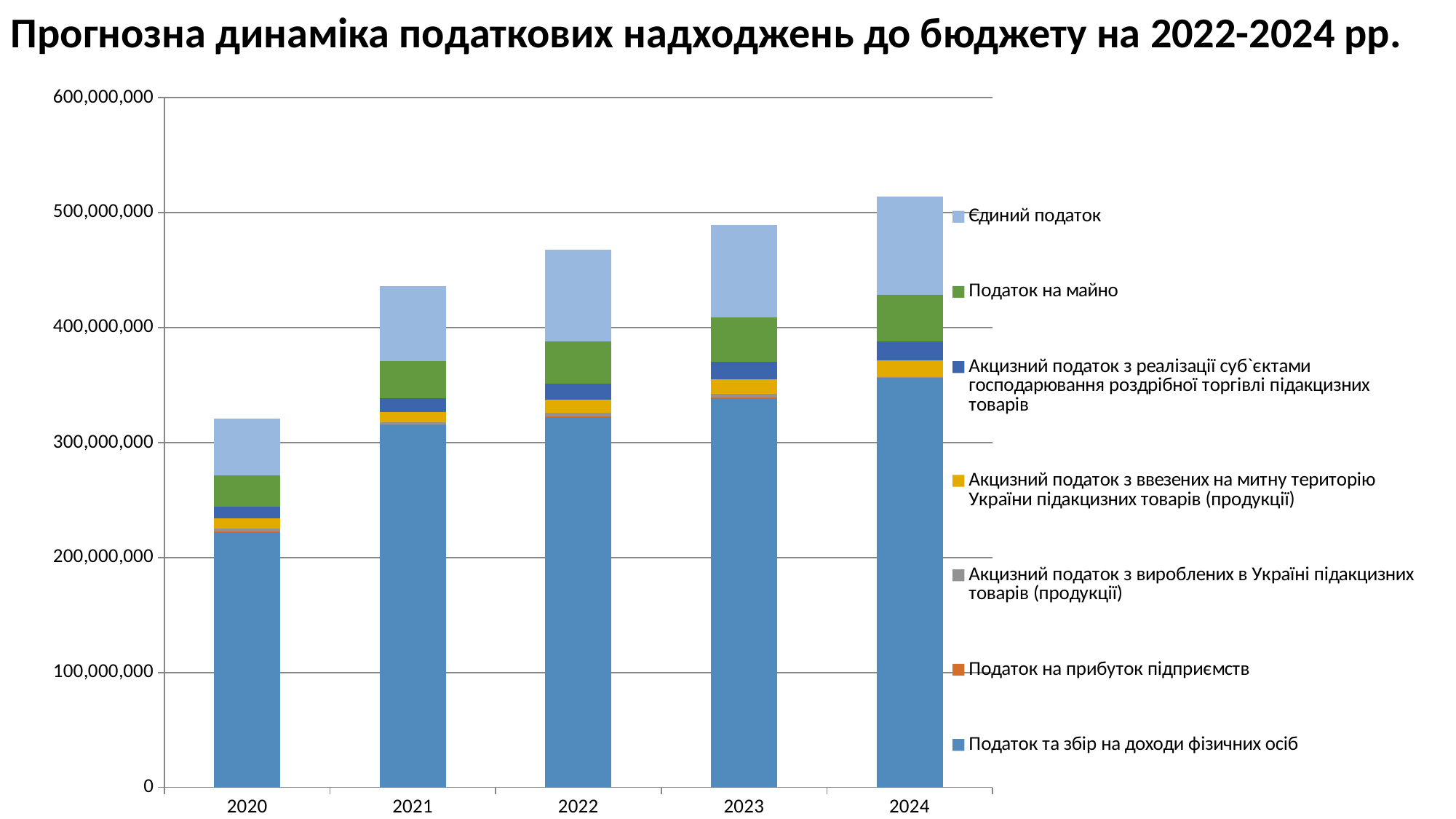
What kind of chart is shown on the slide? stacked bar chart How many series does the legend of the chart list? 7 What is the title of the chart on the slide? Прогнозна динаміка податкових надходжень до бюджету на 2022-2024 рр. Which year has the tallest stacked bar in the chart? 2024 How many years are shown on the x axis of the chart? 5 Is the total stacked bar for 2021 taller or shorter than the total stacked bar for 2022? shorter Is the total stacked bar for 2024 greater or less than 500,000,000? greater Is the total stacked bar for 2020 greater or less than 300,000,000? greater Do the total bar heights rise or fall from 2020 to 2024? rise Which year has the shortest stacked bar in the chart? 2020 Is the value of 'Податок та збір на доходи фізичних осіб' for 2024 greater or less than 300,000,000? greater